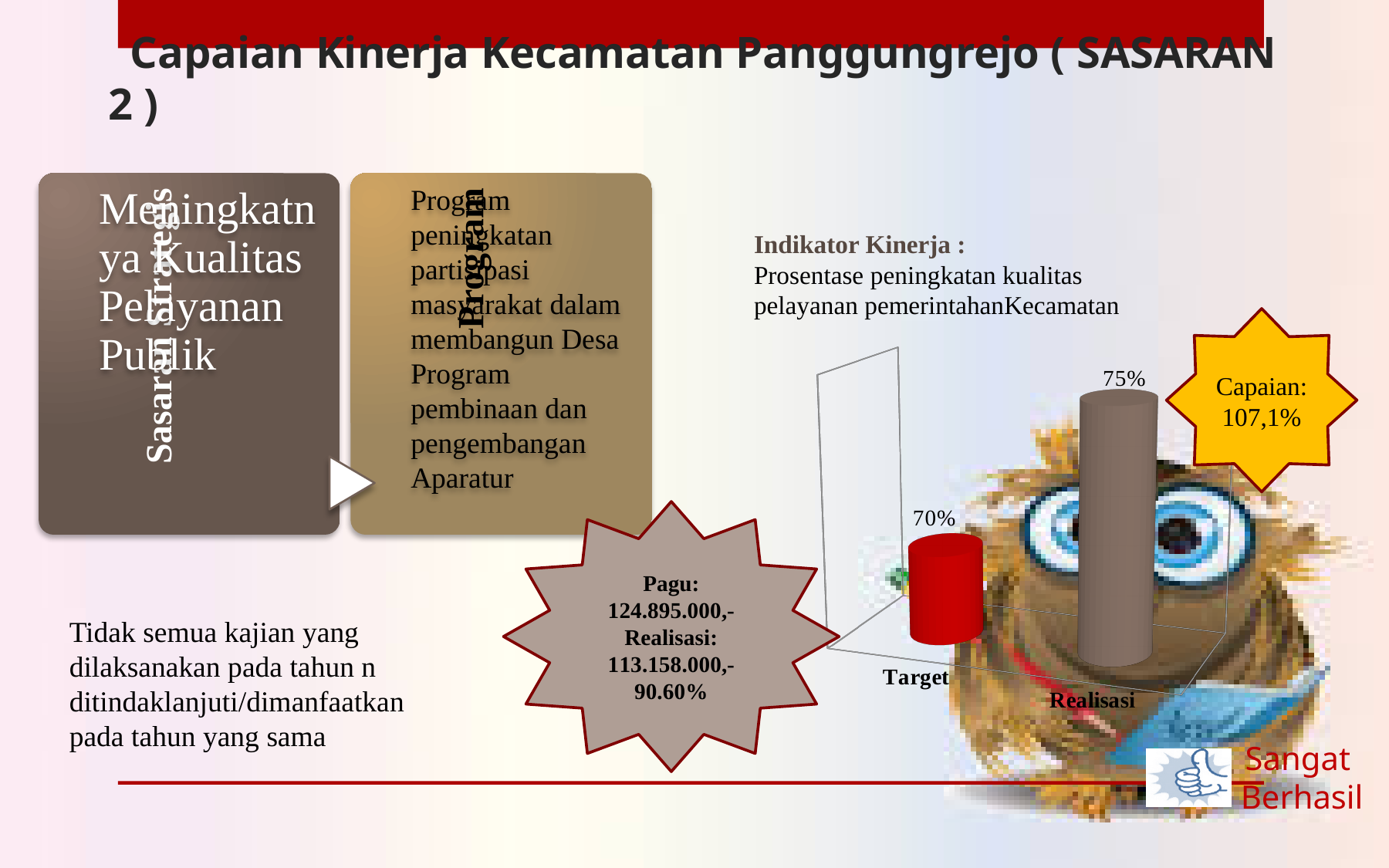
What are the two category labels shown on the chart's x axis? Target and Realisasi What kind of chart is shown on the slide? bar chart What is the difference between the Realisasi value and the Target value in the chart? 5% Is the value for Realisasi larger or smaller than the value for Target? larger What is the value for Target in the chart? 70% Which category has the higher value in the chart, Target or Realisasi? Realisasi Which category has the lowest value in the chart? Target What colour is the Target bar in the chart? red How many categories are plotted in the chart? 2 What is the value for Realisasi in the chart? 75% Do the values rise or fall from Target to Realisasi in the chart? rise